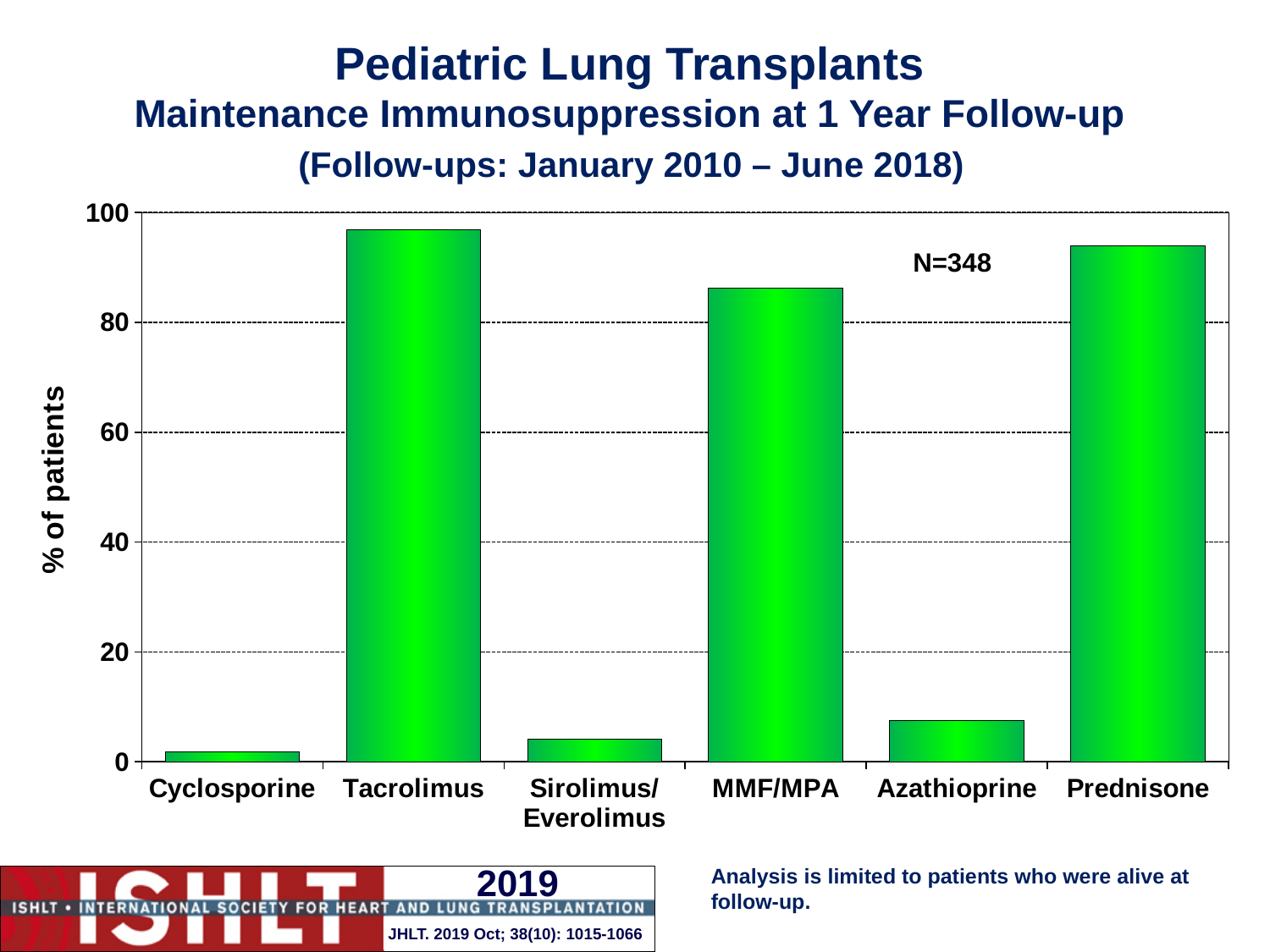
Is the value for Sirolimus/Everolimus greater or less than 20? less Which is larger, the value for Prednisone or the value for MMF/MPA? Prednisone Is the value for Tacrolimus greater or less than 80? greater Which category has the lowest % of patients? Cyclosporine What sample size (N) is printed on the chart? N=348 Is the value for MMF/MPA greater or less than 80? greater Which is larger, the value for Azathioprine or the value for Cyclosporine? Azathioprine What kind of chart is shown on the slide? bar chart Which category has the highest % of patients? Tacrolimus How many immunosuppression categories are shown on the x axis? 6 What is the label of the y axis? % of patients